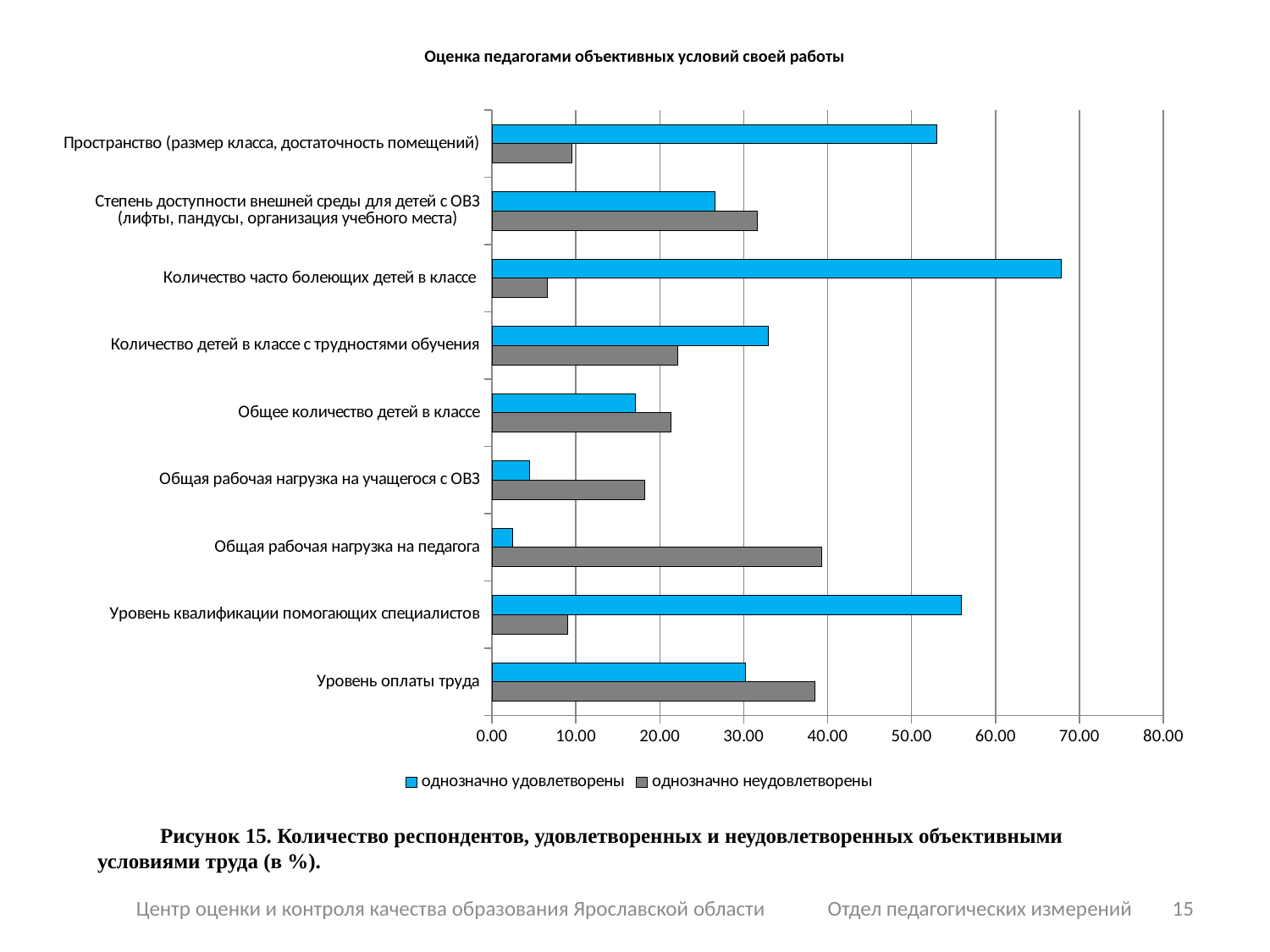
For the category 'Общая рабочая нагрузка на педагога', which series has the larger value? однозначно неудовлетворены Is the value for 'однозначно удовлетворены' in the category 'Общая рабочая нагрузка на педагога' greater or less than 10.00? less Which category has the highest value for the series 'однозначно удовлетворены'? Количество часто болеющих детей в классе How many series does the legend list? 2 Which category has the lowest value for the series 'однозначно неудовлетворены'? Количество часто болеющих детей в классе How many categories are plotted on the chart? 9 What kind of chart is shown on the slide? bar chart What is the title of the chart? Оценка педагогами объективных условий своей работы Is the value for 'однозначно неудовлетворены' in the category 'Общая рабочая нагрузка на педагога' greater or less than 30.00? greater For the category 'Уровень квалификации помогающих специалистов', which series has the larger value? однозначно удовлетворены Is the value for 'однозначно удовлетворены' in the category 'Пространство (размер класса, достаточность помещений)' greater or less than 50.00? greater Which category has the lowest value for the series 'однозначно удовлетворены'? Общая рабочая нагрузка на педагога